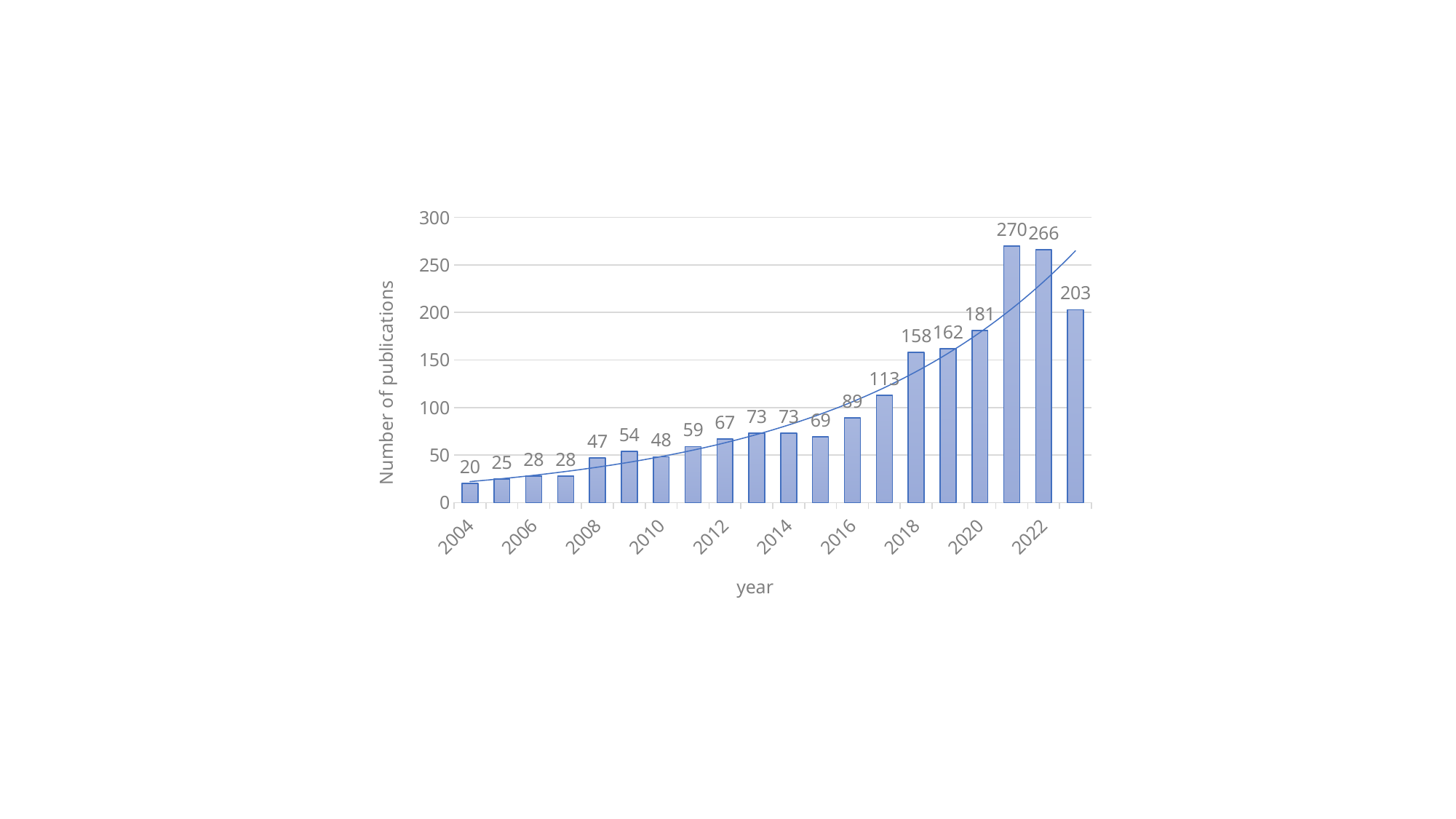
How many bars are plotted in the chart? 20 What type of chart is shown on the slide? bar chart What is the label of the vertical axis? Number of publications What is the difference in the number of publications between 2022 and 2020? 85 What is the number of publications in 2016? 89 Which year has the lowest number of publications? 2004 Which year has the highest number of publications? 2021 What is the number of publications in 2020? 181 Do the number of publications generally rise or fall from 2004 to 2021? rise What is the number of publications in 2022? 266 Which year has more publications, 2018 or 2012? 2018 What is the number of publications in 2004? 20